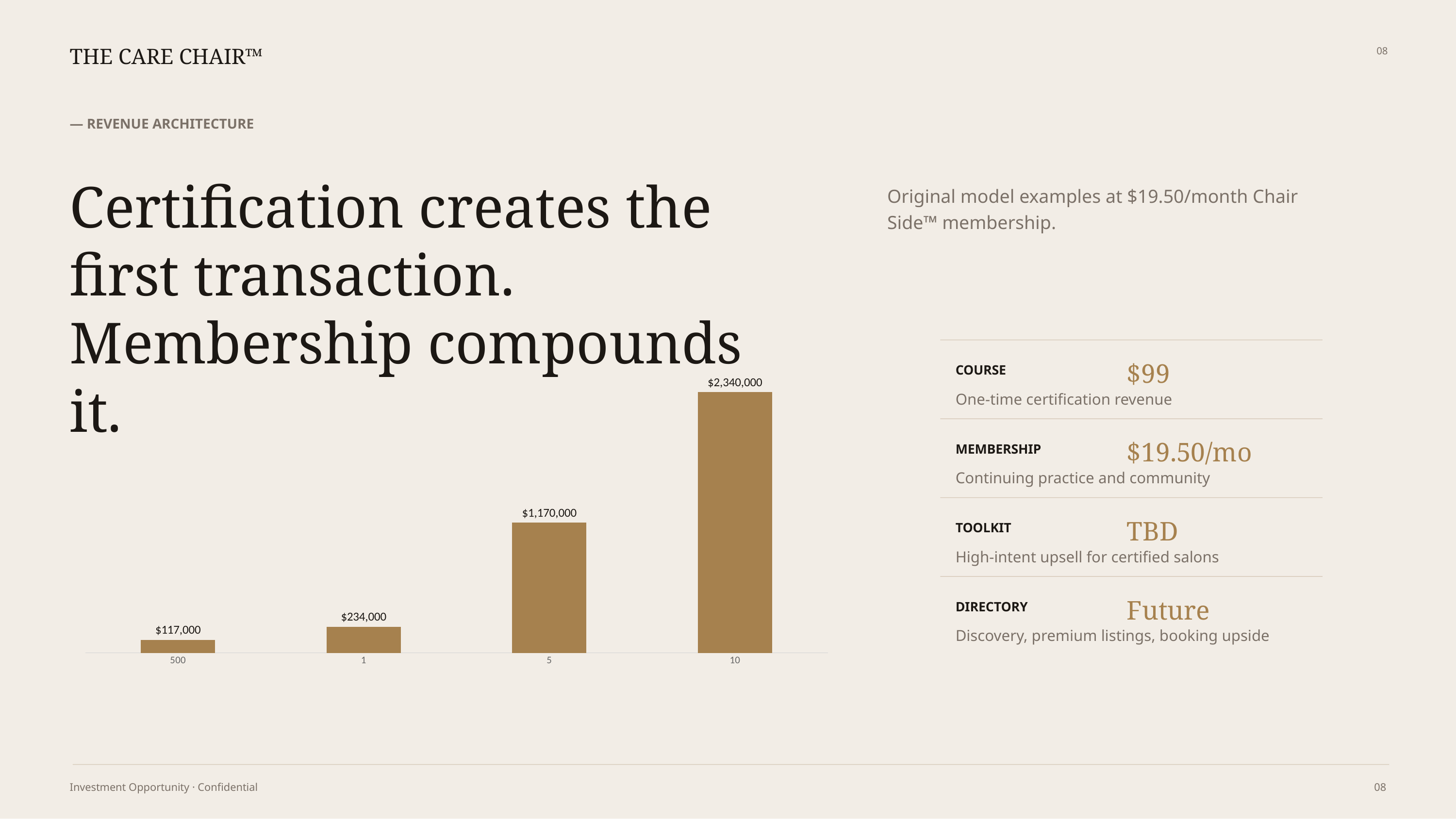
What value is shown for the bar labelled 10 on the x axis? $2,340,000 What value is shown for the bar labelled 5 on the x axis? $1,170,000 What is the difference between the values for the bars labelled 10 and 5? $1,170,000 Which is larger, the value for the bar labelled 5 or the bar labelled 1? 5 What value is shown for the bar labelled 500 on the x axis? $117,000 Do the bar values rise or fall from left to right along the x axis? Rise What is the difference between the values for the bars labelled 1 and 500? $117,000 Which x-axis category has the highest bar? 10 What value is shown for the bar labelled 1 on the x axis? $234,000 How many bars are plotted in the chart? 4 Which x-axis category has the lowest bar? 500 What kind of chart is shown on the slide? Bar chart